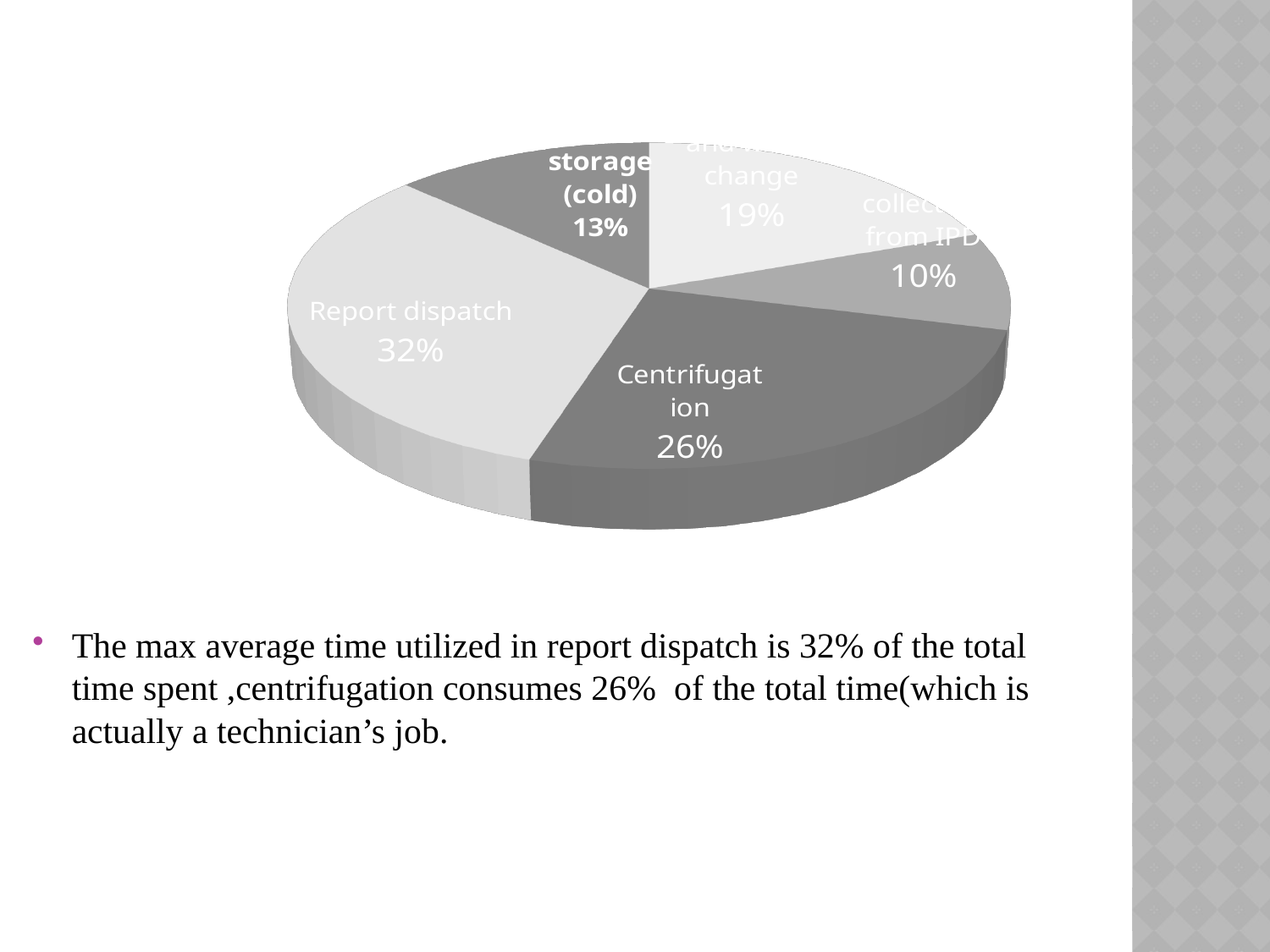
Which is larger in the pie chart, Report dispatch or Centrifugation? Report dispatch Which is larger in the pie chart, Centrifugation or storage (cold)? Centrifugation What kind of chart is shown on the slide? Pie chart Which slice of the pie chart is the largest? Report dispatch What percentage of the pie chart does storage (cold) account for? 13% What percentage of the pie chart does Report dispatch account for? 32% Is the share for storage (cold) in the pie chart greater or less than 20%? less How many slices does the pie chart have? 5 How many percentage points larger is Report dispatch than Centrifugation in the pie chart? 6% What share of the pie chart do Report dispatch and Centrifugation make up together? 58% What percentage of the pie chart does Centrifugation account for? 26% How many percentage points larger is Centrifugation than storage (cold) in the pie chart? 13%